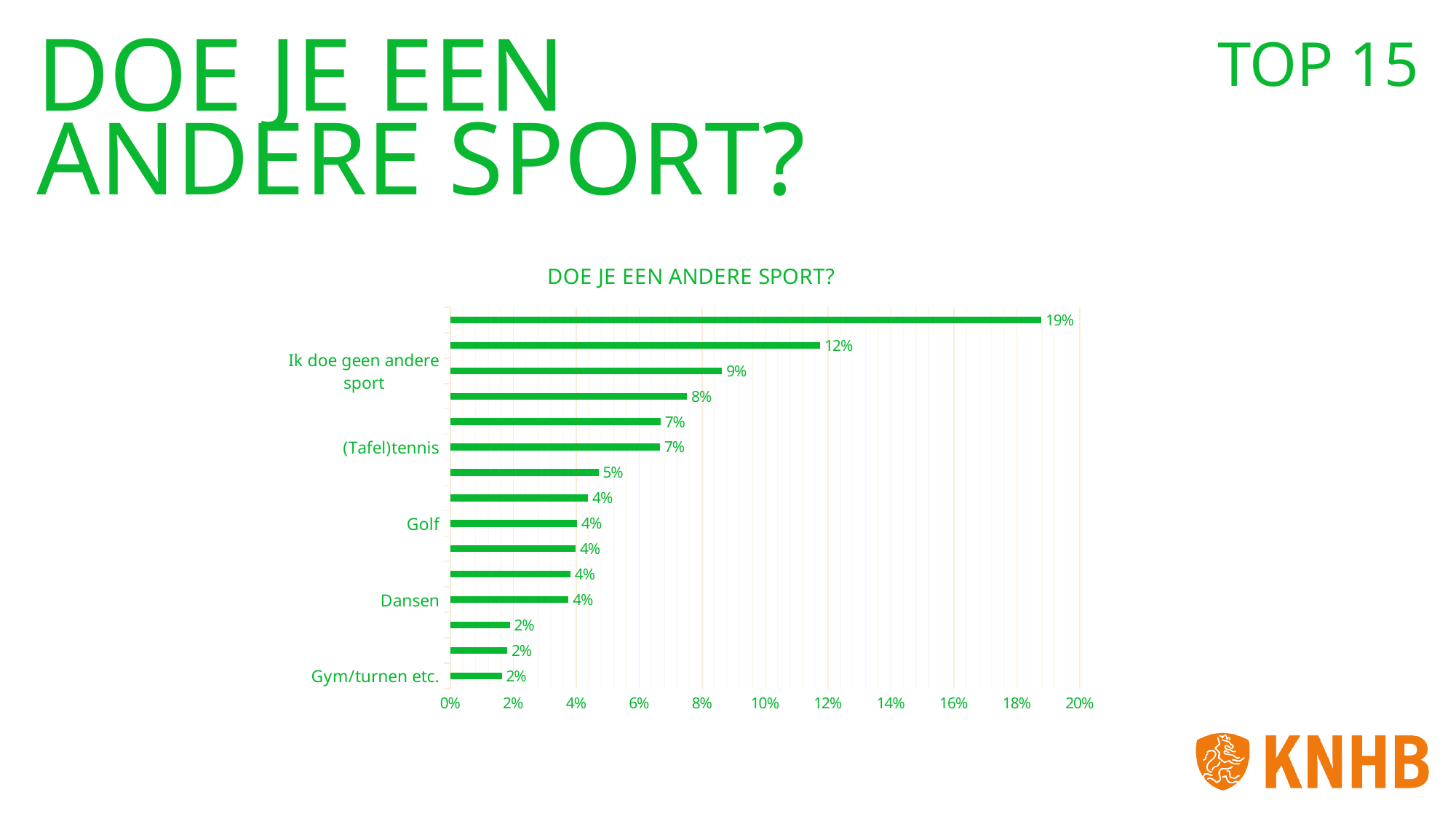
What is the value for (Tafel)tennis? 7% What is the maximum value shown on the horizontal axis? 20% What is the value for Ik doe geen andere sport? 9% What is the difference between the values for (Tafel)tennis and Golf? 3% Which is larger, the value for (Tafel)tennis or the value for Gym/turnen etc.? (Tafel)tennis What is the highest value shown in the chart? 19% What is the value for Golf? 4% What is the value for Gym/turnen etc.? 2% What is the value for Dansen? 4% How many bars are plotted in the chart? 15 What kind of chart is shown on the slide? bar chart What is the title of the chart? DOE JE EEN ANDERE SPORT?